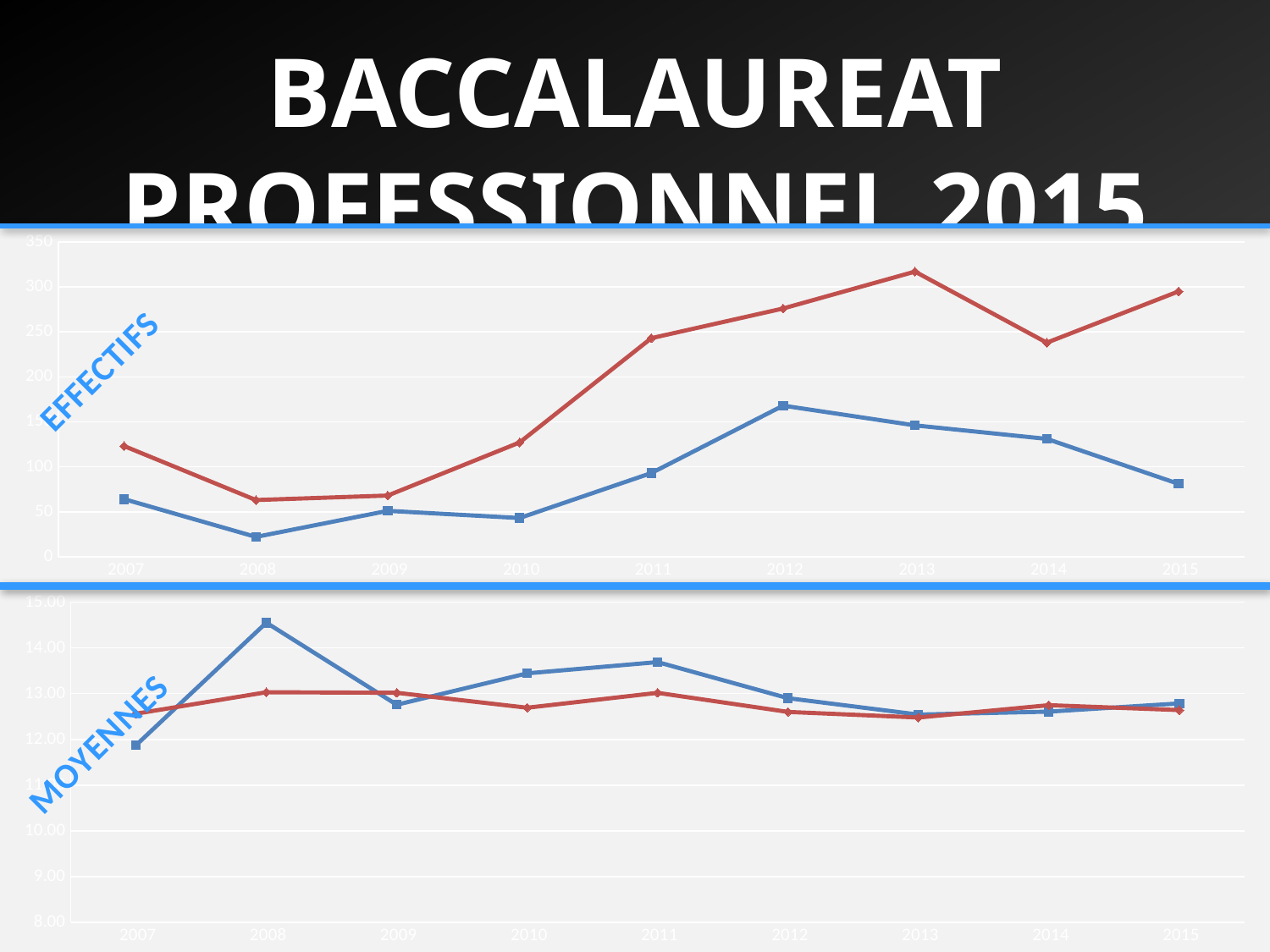
In the EFFECTIFS chart, in which year does the red line reach its highest value? 2013 What kind of chart is the EFFECTIFS chart at the top of the slide? line chart How many years are shown on the x axis of the MOYENNES chart at the bottom of the slide? 9 In the EFFECTIFS chart, is the value of the blue line in 2015 greater or less than 100? less In the MOYENNES chart, in which year does the blue line reach its highest value? 2008 In the MOYENNES chart, is the value of the blue line in 2008 greater or less than 14.00? greater In the MOYENNES chart, in which year does the blue line reach its lowest value? 2007 In the EFFECTIFS chart, which line has the larger value in 2011, the red line or the blue line? the red line In the EFFECTIFS chart, in which year does the blue line reach its highest value? 2012 In the EFFECTIFS chart, does the red line rise or fall between 2008 and 2013? rise In the EFFECTIFS chart, in which year does the blue line reach its lowest value? 2008 In the EFFECTIFS chart, is the value of the red line in 2013 greater or less than 300? greater